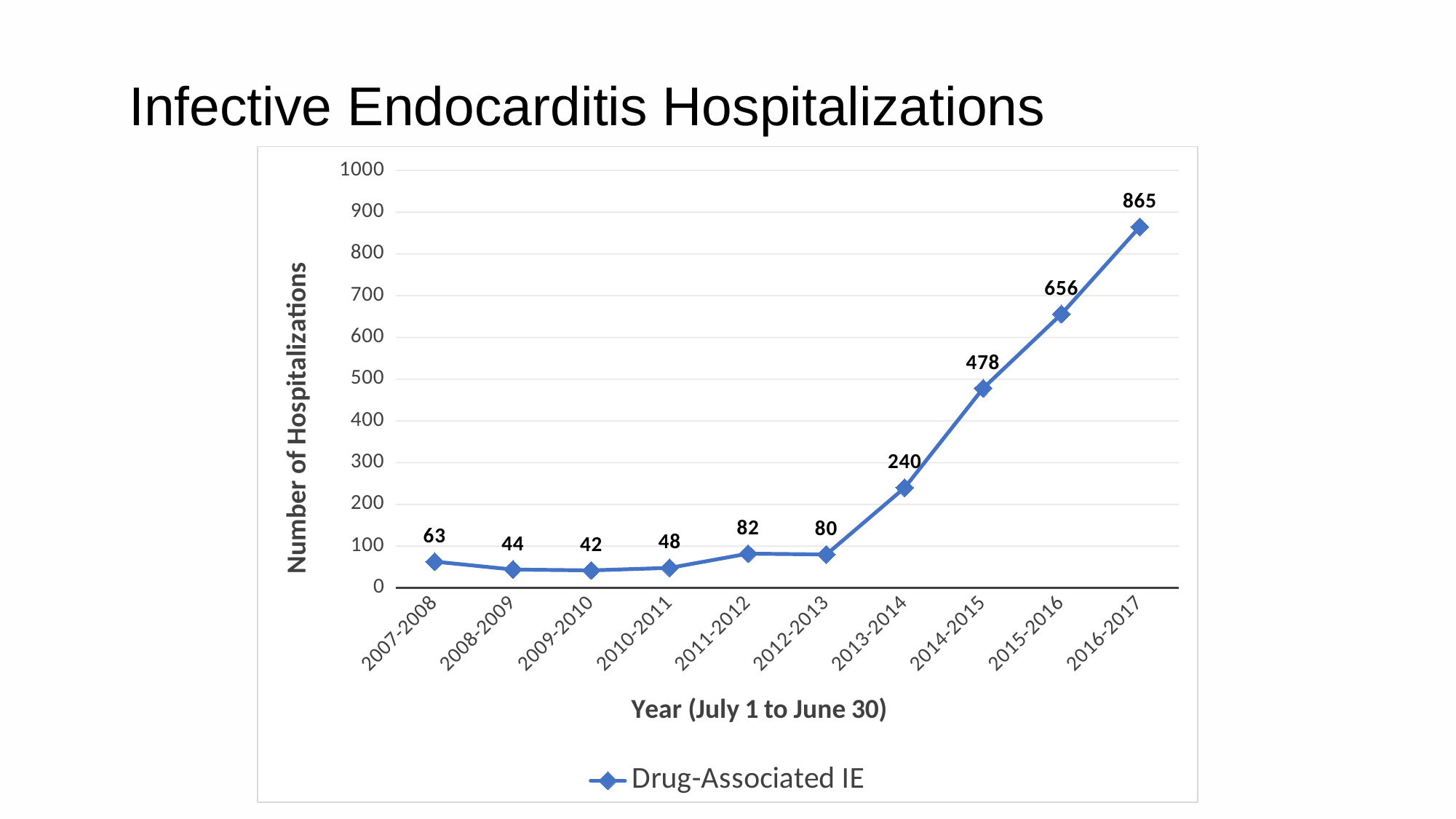
How many series does the chart legend list? 1 What kind of chart is shown on the slide? Line chart Which year has the lowest number of Drug-Associated IE hospitalizations? 2009-2010 What is the label of the y axis of the chart? Number of Hospitalizations Which year has the highest number of Drug-Associated IE hospitalizations? 2016-2017 What is the number of Drug-Associated IE hospitalizations in 2015-2016? 656 Which year had more Drug-Associated IE hospitalizations, 2011-2012 or 2012-2013? 2011-2012 What is the number of Drug-Associated IE hospitalizations in 2013-2014? 240 What is the difference in Drug-Associated IE hospitalizations between 2014-2015 and 2013-2014? 238 What is the difference in Drug-Associated IE hospitalizations between 2016-2017 and 2015-2016? 209 What is the number of Drug-Associated IE hospitalizations in 2007-2008? 63 How many years are plotted on the x axis of the chart? 10